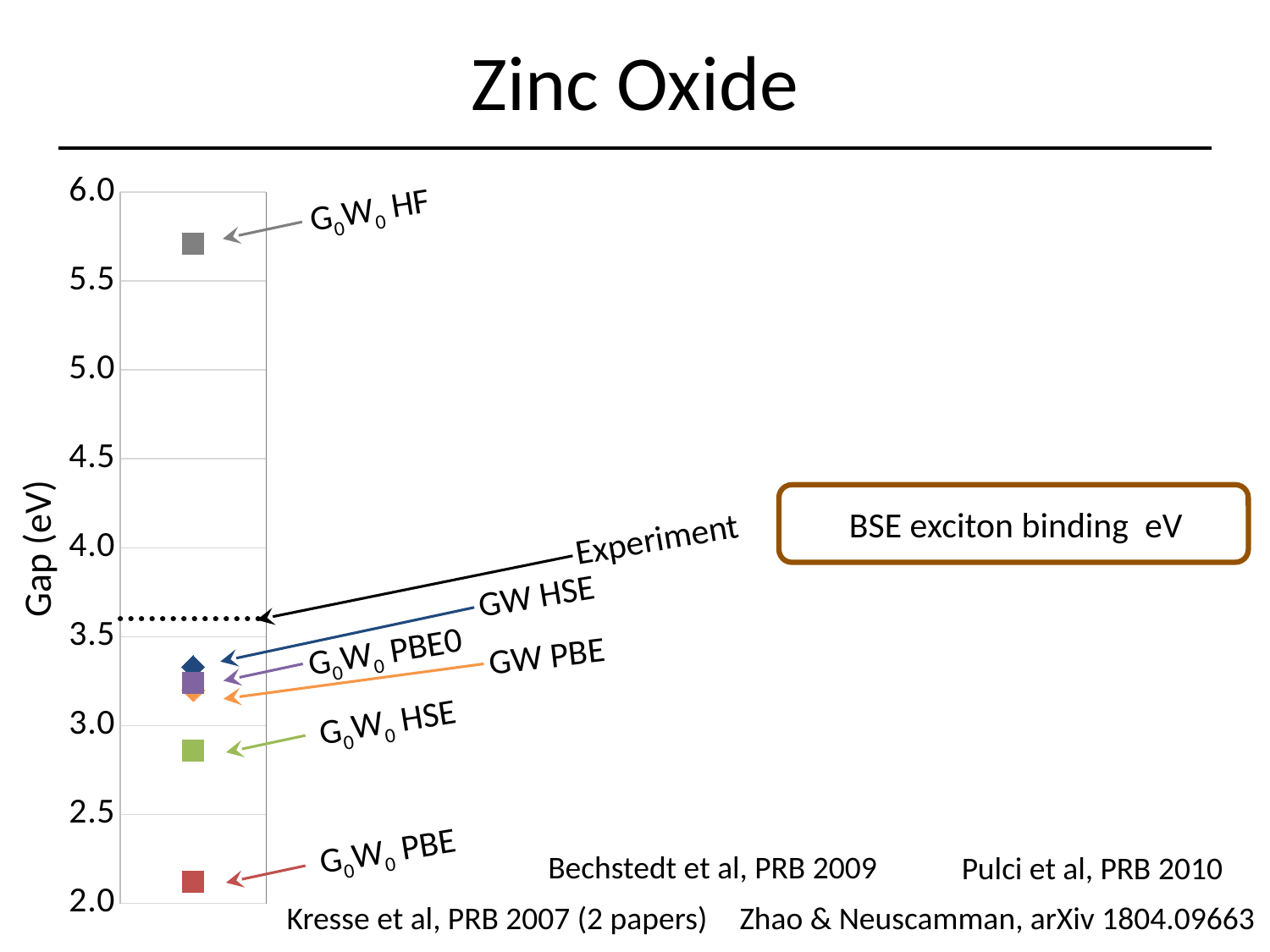
Which has the larger gap value, GW PBE or G0W0 HSE? GW PBE How many method data points (markers) are plotted on the chart? 6 What kind of chart is shown on the slide? scatter chart Is the gap value for GW HSE greater or less than 3.5? less Which method gives the highest gap value on the chart? G0W0 HF Which has the larger gap value, G0W0 HSE or G0W0 PBE? G0W0 HSE Is the gap value for G0W0 HSE greater or less than 3.0? less Is the gap value for G0W0 PBE greater or less than 2.5? less Which method gives the lowest gap value on the chart? G0W0 PBE What is the label of the vertical axis? Gap (eV)